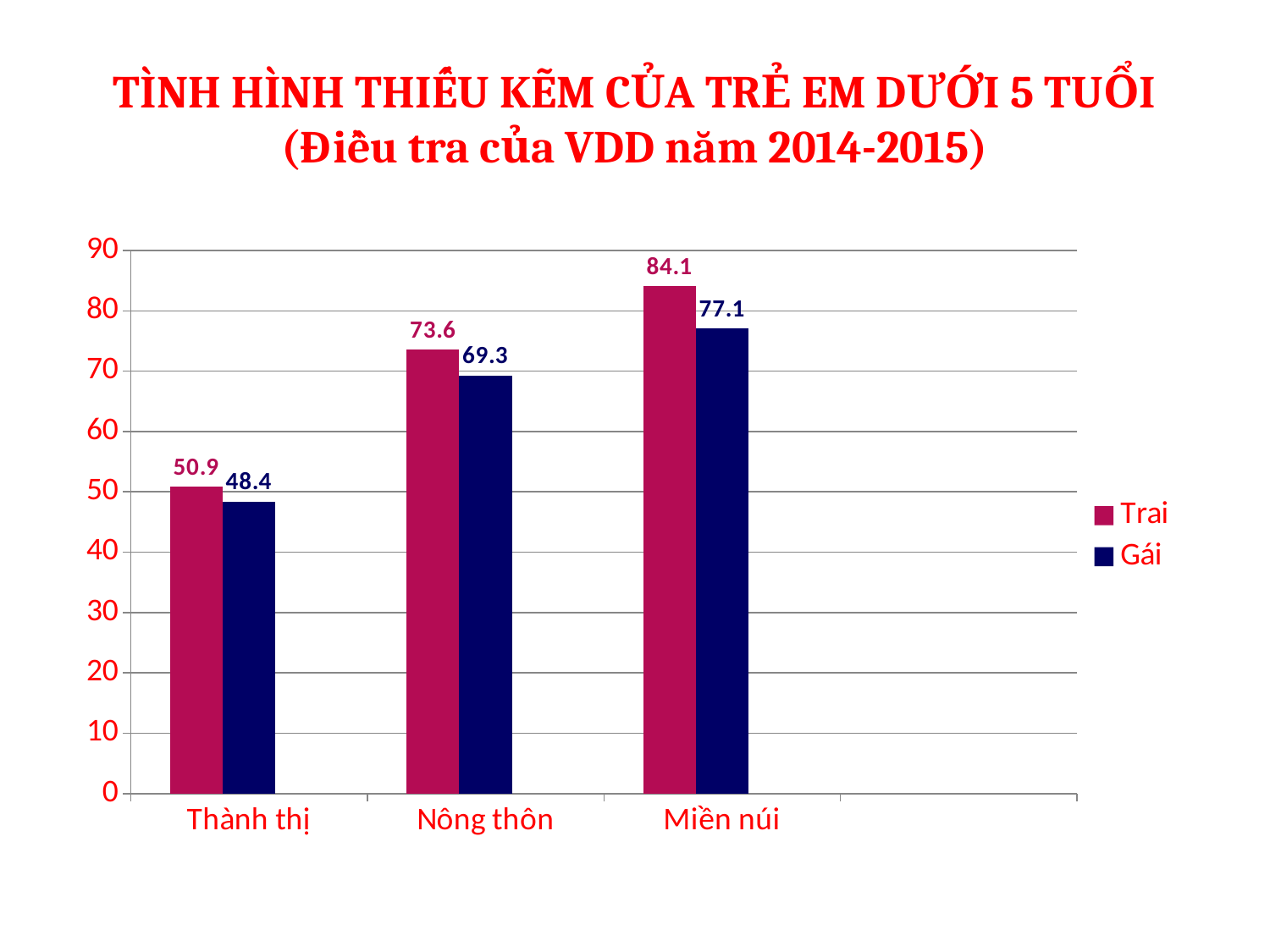
Which is larger: the Gái value in Nông thôn or the Trai value in Thành thị? Gái value in Nông thôn How many series does the legend list? 2 Do the Trai values rise or fall from Thành thị to Miền núi? Rise Which category has the highest value for Trai? Miền núi What is the value for Gái in Miền núi? 77.1 Which category has the lowest value for Gái? Thành thị What is the difference between the Trai and Gái values in Miền núi? 7.0 What is the value for Trai in Thành thị? 50.9 What is the difference between the Trai values for Nông thôn and Thành thị? 22.7 How many categories are shown on the x axis? 3 What is the value for Gái in Nông thôn? 69.3 What kind of chart is shown on the slide? Bar chart